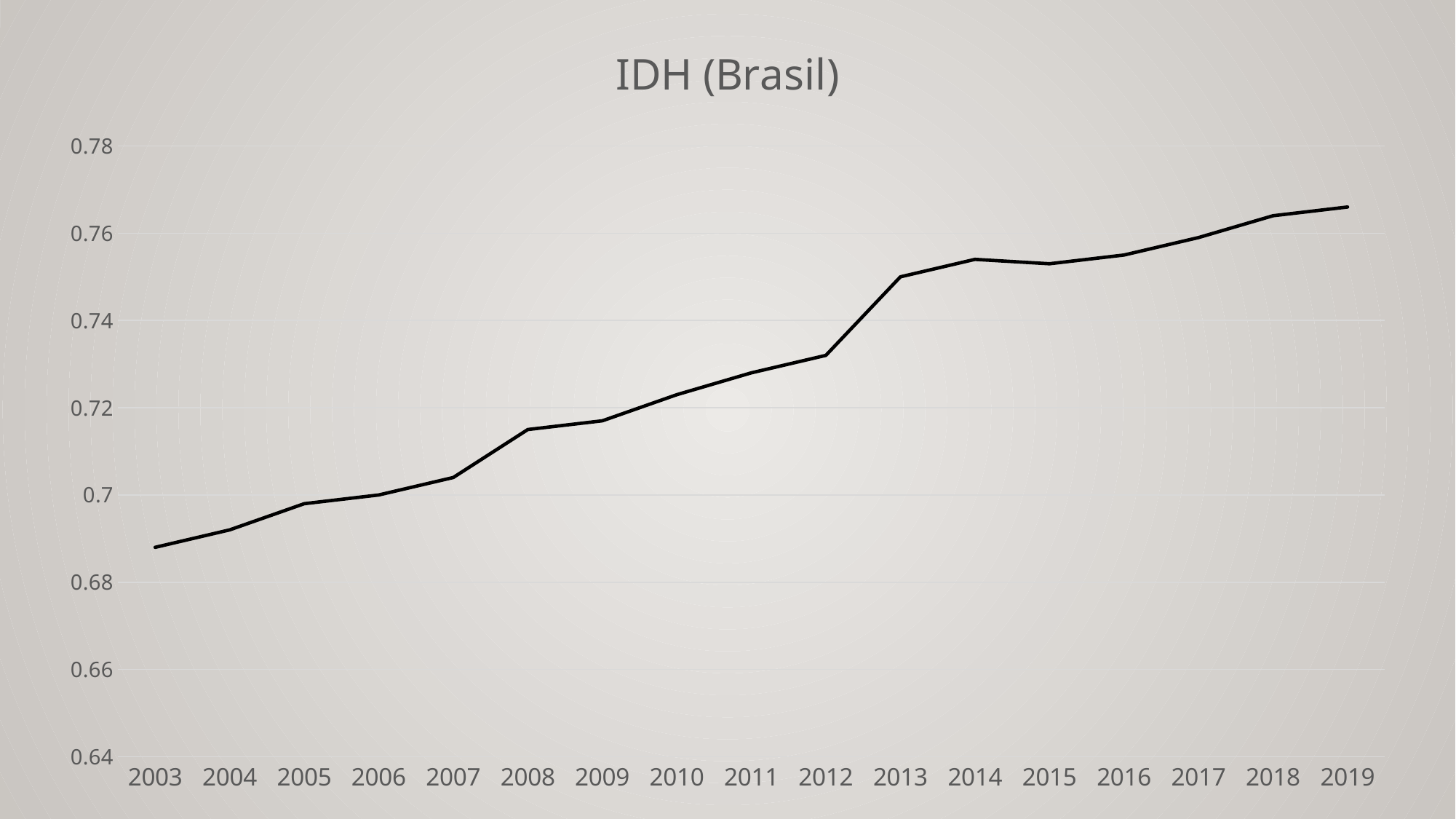
Which year has the larger value, 2012 or 2013? 2013 Which year has the lowest IDH value? 2003 Is the value for 2012 greater or less than 0.72? greater Is the value for 2013 greater or less than 0.74? greater Is the value for 2008 greater or less than 0.72? less What type of chart is shown on the slide? line chart Which year has the highest IDH value? 2019 Do the values generally rise or fall from 2003 to 2019? rise What is the title of the chart? IDH (Brasil) How many years are plotted on the x axis? 17